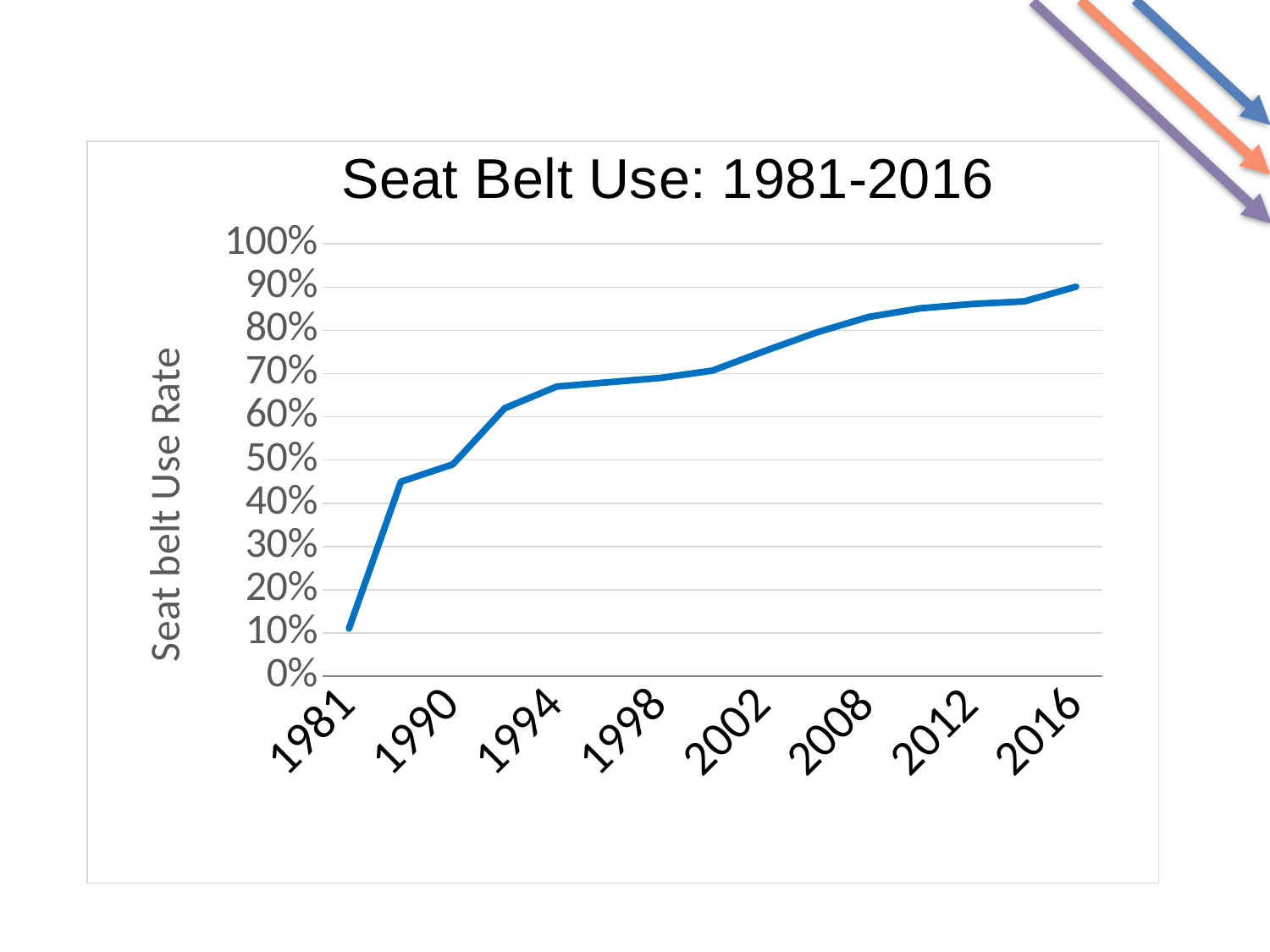
Is the seat belt use rate for 2002 greater or less than 60%? greater What kind of chart is shown on the slide? line chart Is the seat belt use rate for 1994 greater or less than 50%? greater Which labeled year has the lowest seat belt use rate? 1981 Is the seat belt use rate for 2016 greater or less than 80%? greater What is the label on the vertical axis of the chart? Seat belt Use Rate Do the seat belt use rate values rise or fall from 1981 to 2016? rise What is the title of the chart? Seat Belt Use: 1981-2016 Which year has a higher seat belt use rate, 1990 or 2008? 2008 Which labeled year has the highest seat belt use rate? 2016